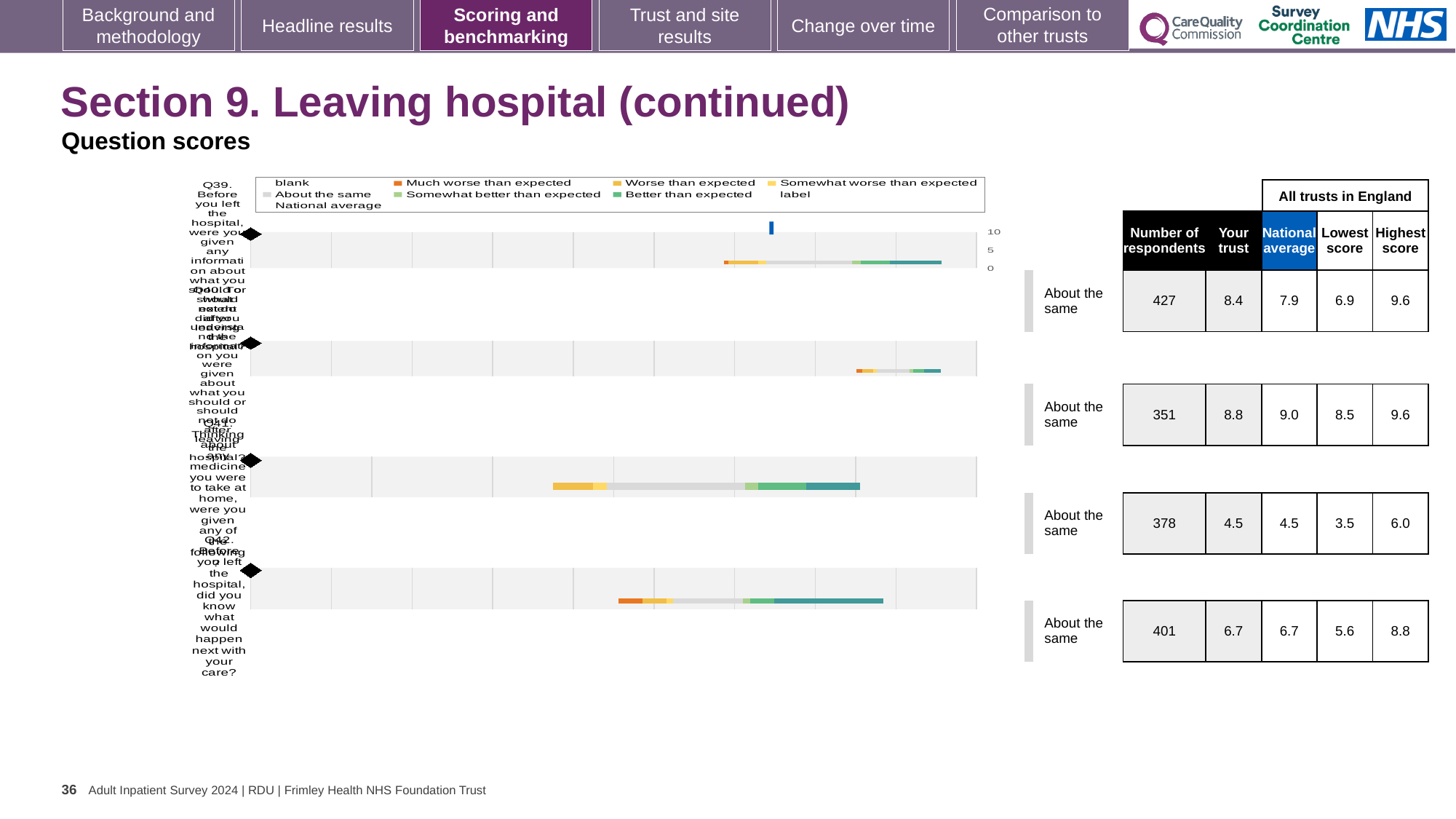
What is the national average for the second question row? 9.0 What is the 'Your trust' score for the first question row (Q39)? 8.4 What kind of chart is shown on the slide? bar chart How many question rows (bars) are plotted in the chart? 4 What is the lowest score among all trusts in England for the last question row (Q42)? 5.6 Which question row has the lowest 'Your trust' score? the third row, 4.5 What is the number of respondents for the first question row (Q39)? 427 What is the highest score among all trusts in England for the third question row? 6.0 What benchmark category is shown next to each of the four question rows? About the same Which question row has the highest number of respondents? the first row (Q39), 427 What is the difference between the 'Your trust' score and the national average for the first question row (Q39)? 0.5 Is the 'Your trust' score for the second question row larger or smaller than its national average? smaller